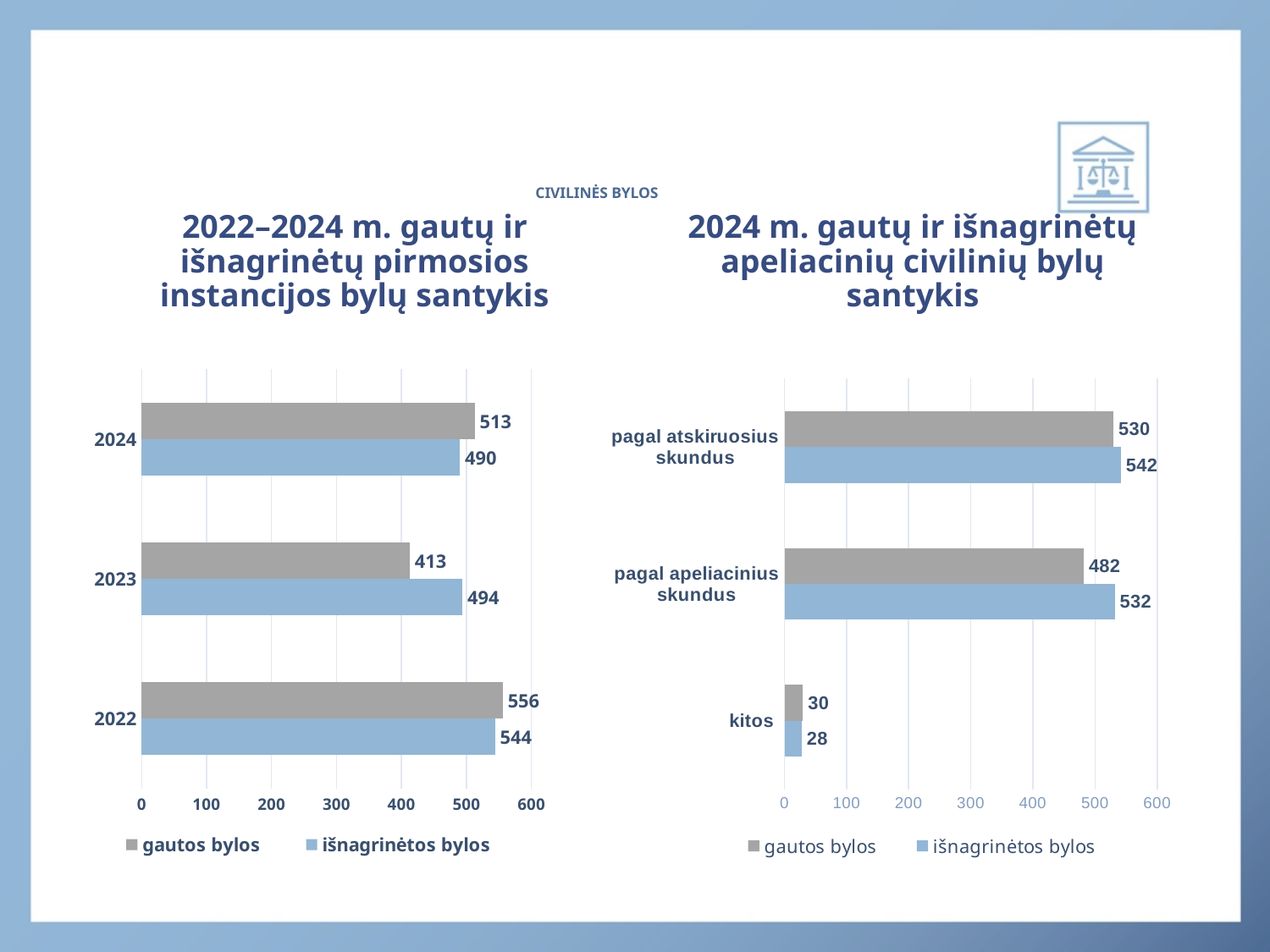
In the right chart, what is the difference between išnagrinėtos bylos and gautos bylos for pagal apeliacinius skundus? 50 In the left chart (2022–2024 m. gautų ir išnagrinėtų pirmosios instancijos bylų santykis), what is the value of gautos bylos for 2024? 513 In the right chart, how many series does the legend list? 2 In the left chart, how many years are shown on the axis? 3 In the left chart, what is the difference between gautos bylos and išnagrinėtos bylos for 2023? 81 In the left chart, which year has the lowest value for gautos bylos? 2023 In the right chart, which is larger for pagal apeliacinius skundus: gautos bylos or išnagrinėtos bylos? išnagrinėtos bylos What kind of chart is the left chart? bar chart In the right chart, what is the value of gautos bylos for kitos? 30 In the right chart (2024 m. gautų ir išnagrinėtų apeliacinių civilinių bylų santykis), what is the value of išnagrinėtos bylos for pagal atskiruosius skundus? 542 In the left chart, what is the value of išnagrinėtos bylos for 2023? 494 In the left chart, which year has the highest value for gautos bylos? 2022